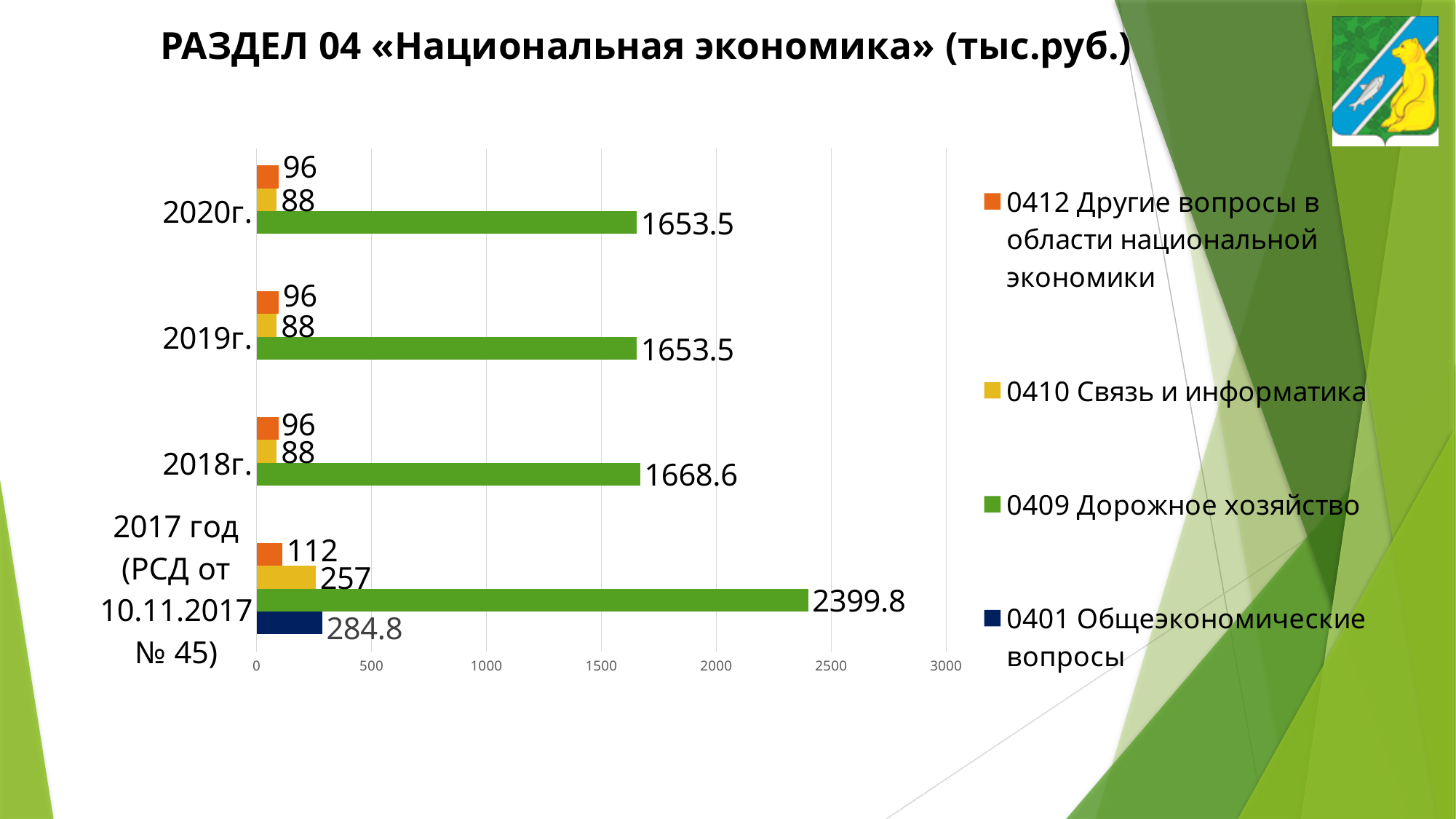
Is the value for 0409 Дорожное хозяйство in 2020г. greater or less than 1500? greater What kind of chart is shown on the slide? bar chart What is the value for 0409 Дорожное хозяйство in 2018г.? 1668.6 What is the value for 0410 Связь и информатика in 2017 год (РСД от 10.11.2017 № 45)? 257 How many series does the legend list? 4 In which year is the value for 0409 Дорожное хозяйство highest? 2017 год (РСД от 10.11.2017 № 45) What is the difference between the 0410 Связь и информатика values for 2017 год and 2018г.? 169 What is the difference between the 0409 Дорожное хозяйство values for 2018г. and 2019г.? 15.1 What colour represents 0409 Дорожное хозяйство in the chart? green What is the value for 0401 Общеэкономические вопросы in 2017 год (РСД от 10.11.2017 № 45)? 284.8 What is the value for 0412 Другие вопросы в области национальной экономики in 2020г.? 96 Which is larger in 2017 год: the value for 0412 Другие вопросы в области национальной экономики or 0410 Связь и информатика? 0410 Связь и информатика